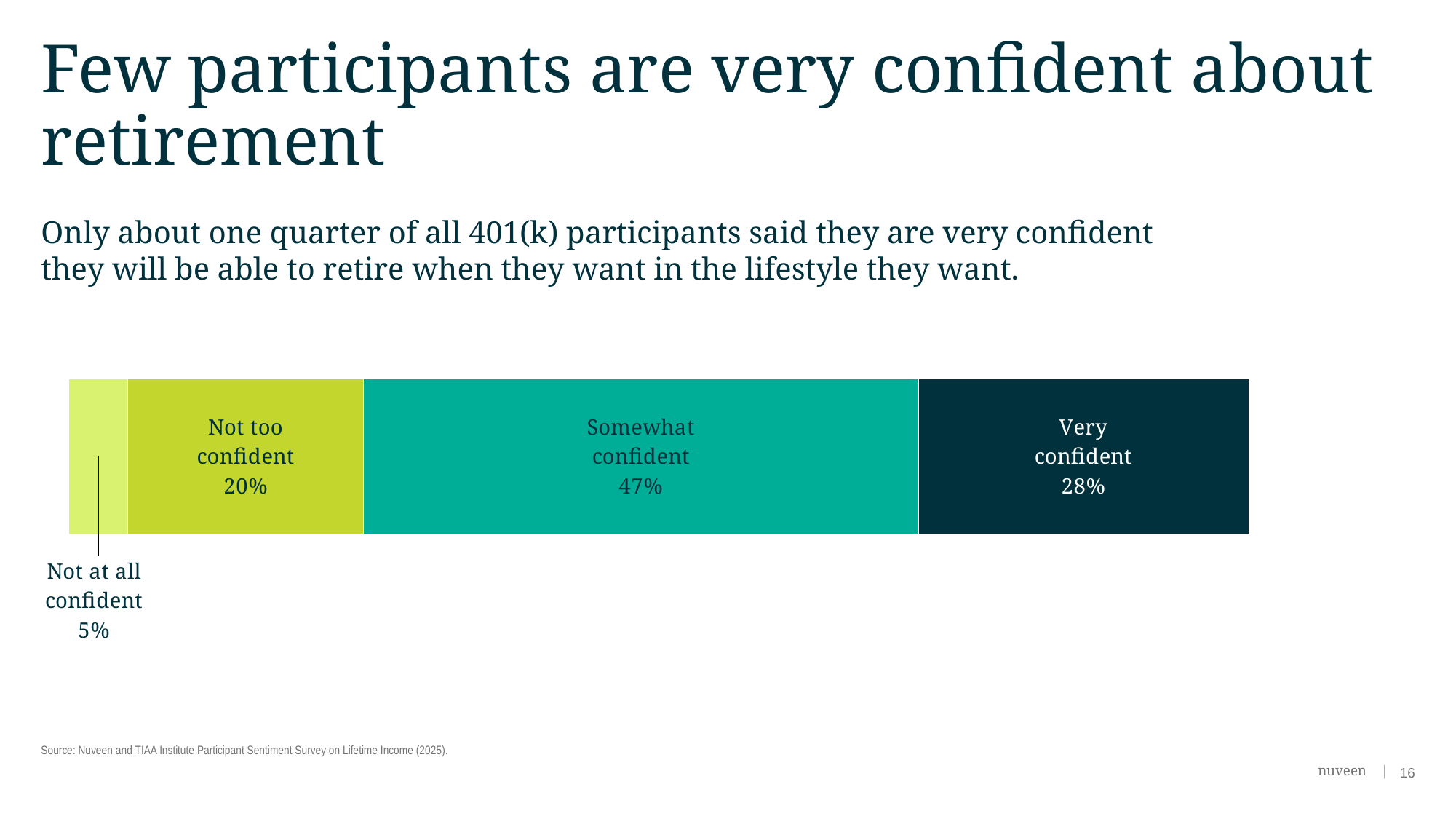
What percentage of participants said they are somewhat confident? 47% What is the total of all four segments in the stacked bar? 100% How many confidence categories are shown in the bar? 4 Which confidence level has the largest share of participants? Somewhat confident What kind of chart is shown on the slide? Stacked bar chart Which is larger, the share for very confident or the share for not too confident? Very confident What percentage of participants said they are not at all confident? 5% What percentage of participants said they are very confident about retirement? 28% What is the difference in percentage points between not too confident and not at all confident? 15 Which confidence level has the smallest share of participants? Not at all confident What is the difference in percentage points between somewhat confident and very confident? 19 What percentage of participants said they are not too confident? 20%